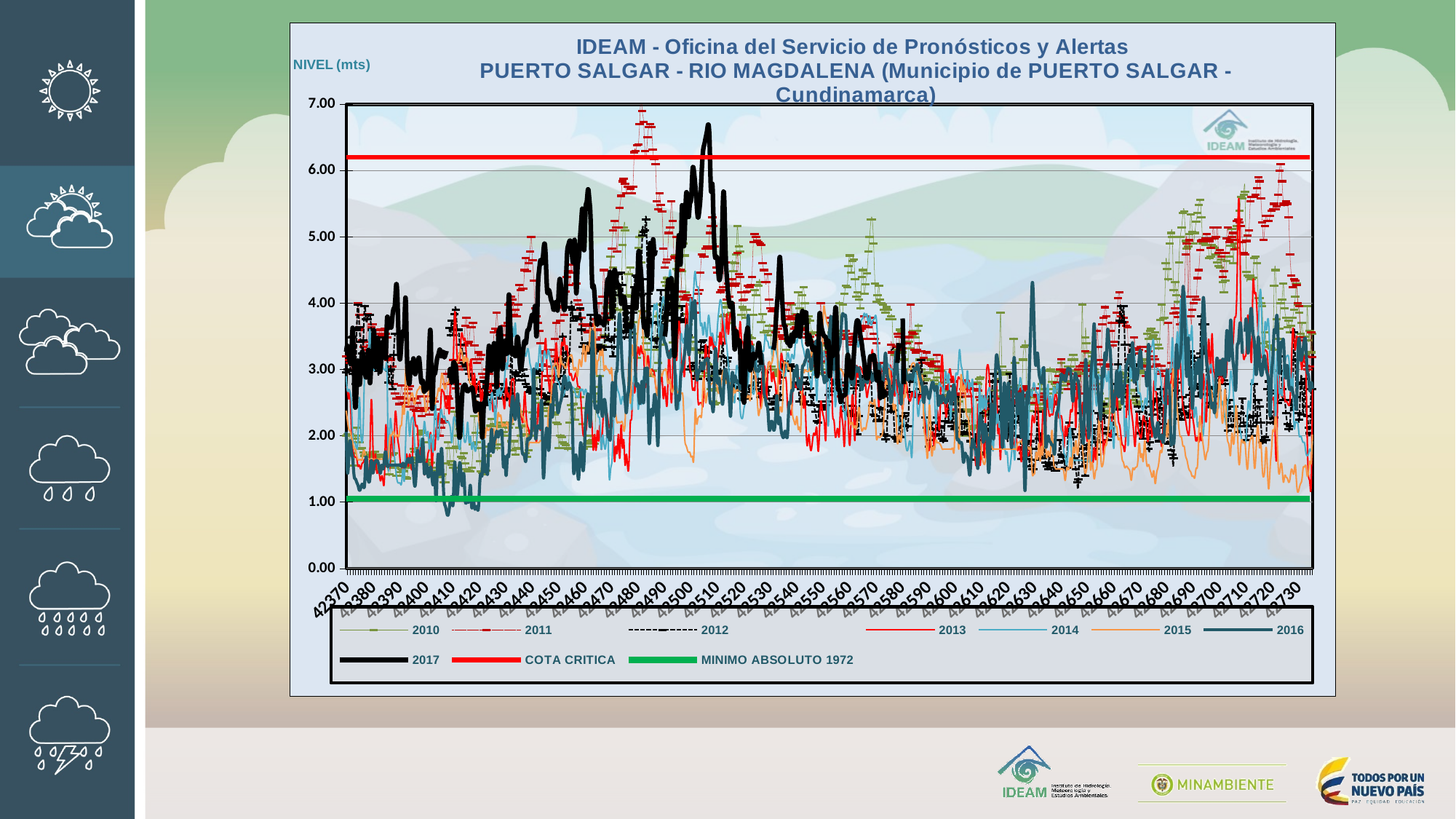
What is the label on the vertical axis of the chart? NIVEL (mts) What is the last tick label shown on the horizontal axis? 42730 What is the first tick label shown on the horizontal axis? 42370 What kind of chart is shown on the slide? line chart How many entries does the chart legend list? 10 Is the COTA CRITICA line greater or less than 6.00 on the vertical axis? greater Which legend entry is drawn as a thick green line? MINIMO ABSOLUTO 1972 Is the MINIMO ABSOLUTO 1972 line greater or less than 2.00 on the vertical axis? less What is the highest tick value shown on the vertical axis? 7.00 Is the highest point of the 2017 series greater or less than 6.00? greater How many labelled tick values are there on the vertical axis? 8 Which is higher on the chart, the COTA CRITICA line or the MINIMO ABSOLUTO 1972 line? COTA CRITICA